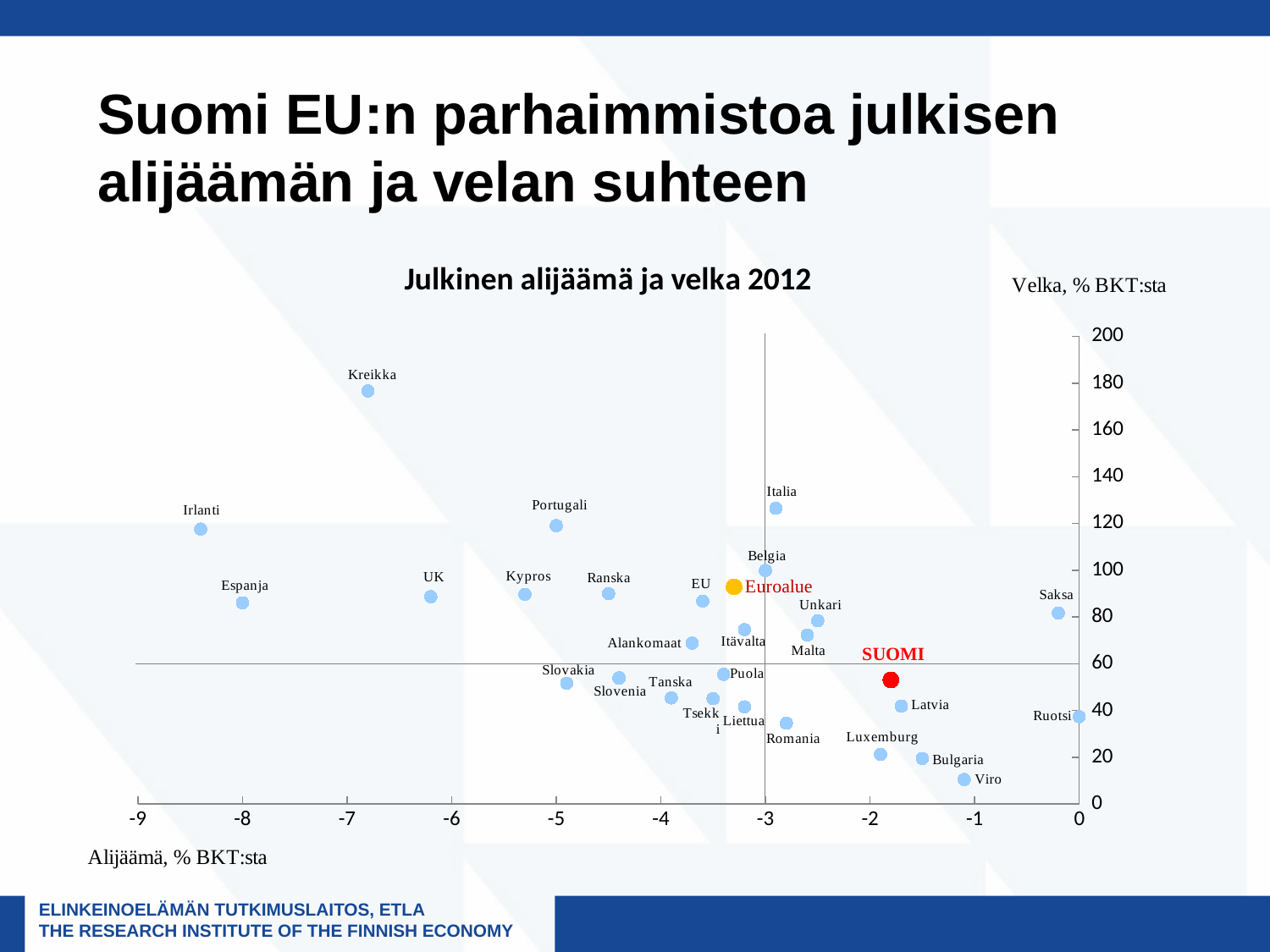
Which country is furthest to the left on the x axis (largest deficit)? Irlanti Is the debt value for Luxemburg greater or less than 40? less What is the title of the chart? Julkinen alijäämä ja velka 2012 Is the debt value for Belgia greater or less than 80? greater Which country has the highest debt (Velka, % BKT:sta) in the chart? Kreikka Is the debt value for Italia greater or less than 120? greater Which has the higher debt value, Irlanti or Espanja? Irlanti Which has the higher debt value, Saksa or Ruotsi? Saksa Which country has the lowest debt (Velka, % BKT:sta) in the chart? Viro What kind of chart is shown on the slide? scatter chart